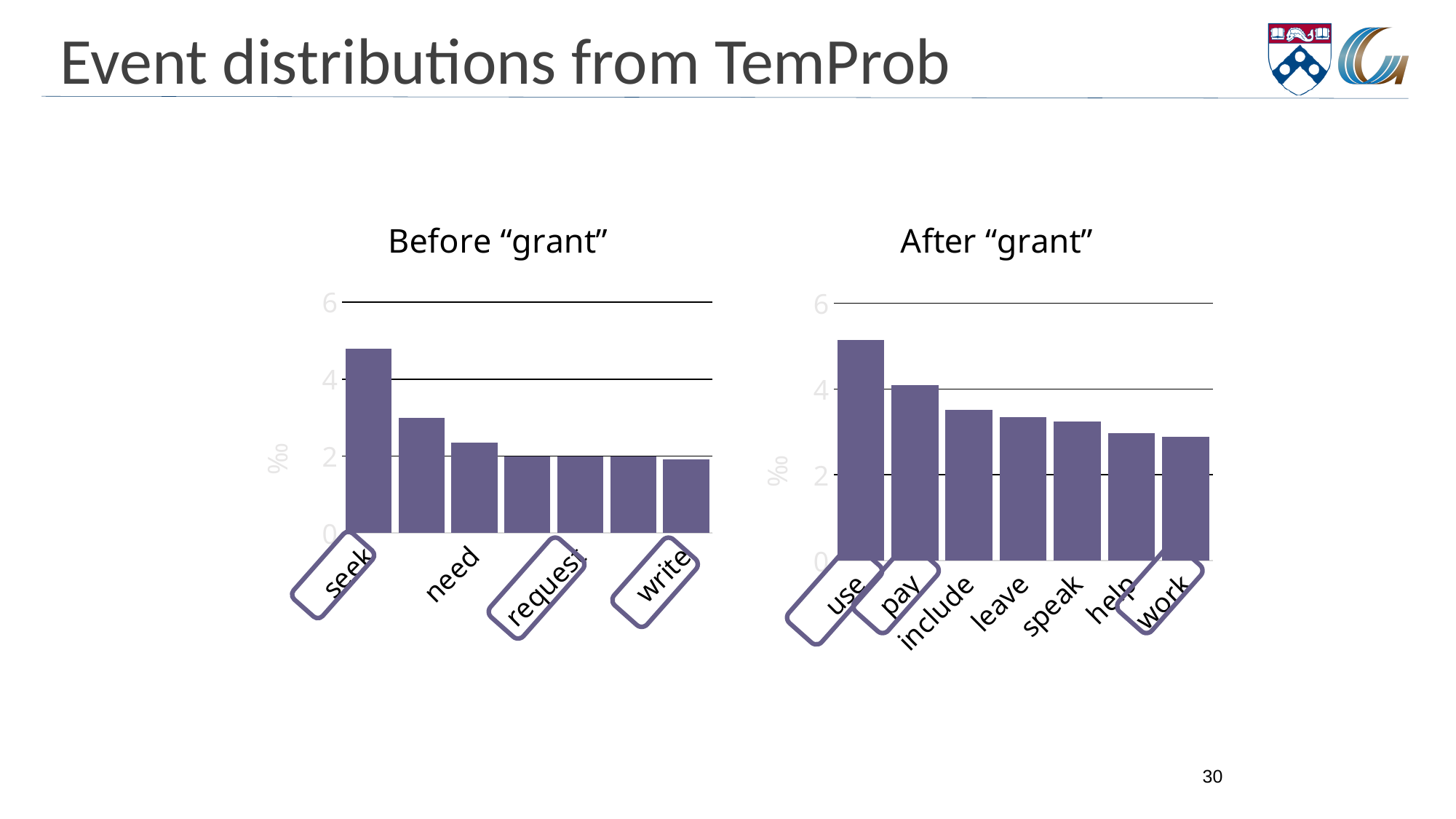
In the "Before "grant"" chart, which labelled event has the lowest value? write In the "After "grant"" chart, which event has the highest value? use What kind of chart is the "Before "grant"" chart? bar chart In the "Before "grant"" chart, which event has the highest value? seek In the "After "grant"" chart, do the values rise or fall from left to right? fall In the "Before "grant"" chart, is the value for seek greater or less than 4? greater In the "After "grant"" chart, is the value for use greater or less than 4? greater How many events are plotted in the "After "grant"" chart? 7 In the "After "grant"" chart, which is larger, use or pay? use In the "Before "grant"" chart, which is larger, seek or need? seek How many bars are plotted in the "Before "grant"" chart? 7